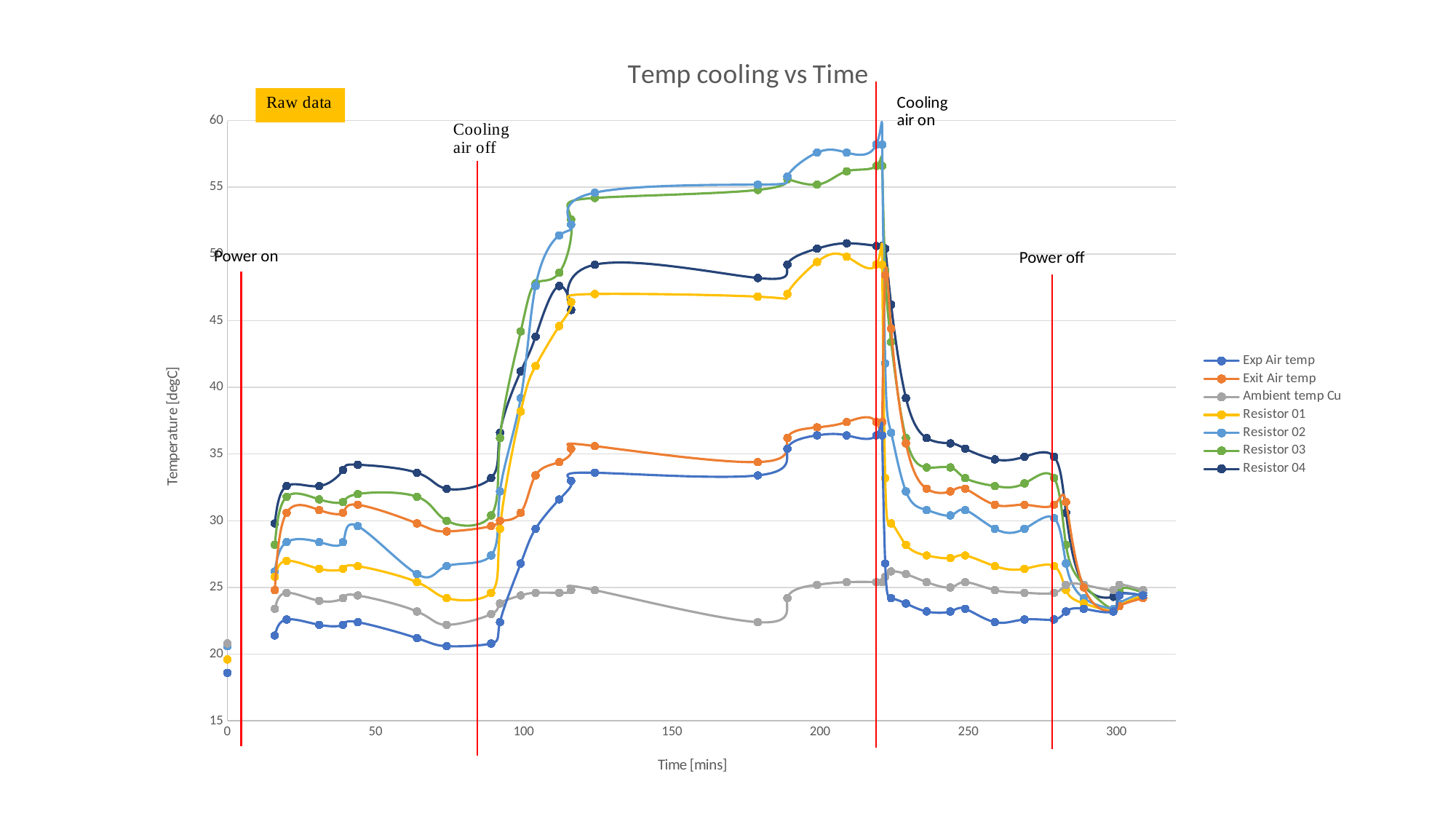
Between the 'Cooling air off' line and the 'Cooling air on' line, do the Resistor 02 values rise or fall? rise What is the title of the chart? Temp cooling vs Time Which series has the lowest value at 150 mins? Ambient temp Cu How many series does the legend list? 7 At 50 mins, which is higher, Resistor 04 or Resistor 02? Resistor 04 What is the label on the vertical axis? Temperature [degC] At 150 mins, which is higher, Resistor 03 or Resistor 01? Resistor 03 Is the value for Ambient temp Cu at 100 mins greater or less than 30? less Which series reaches the highest temperature on the chart? Resistor 02 Is the value for Resistor 04 at 150 mins greater or less than 45? greater Is the value for Exp Air temp at 250 mins greater or less than 25? less What kind of chart is shown on the slide? line chart